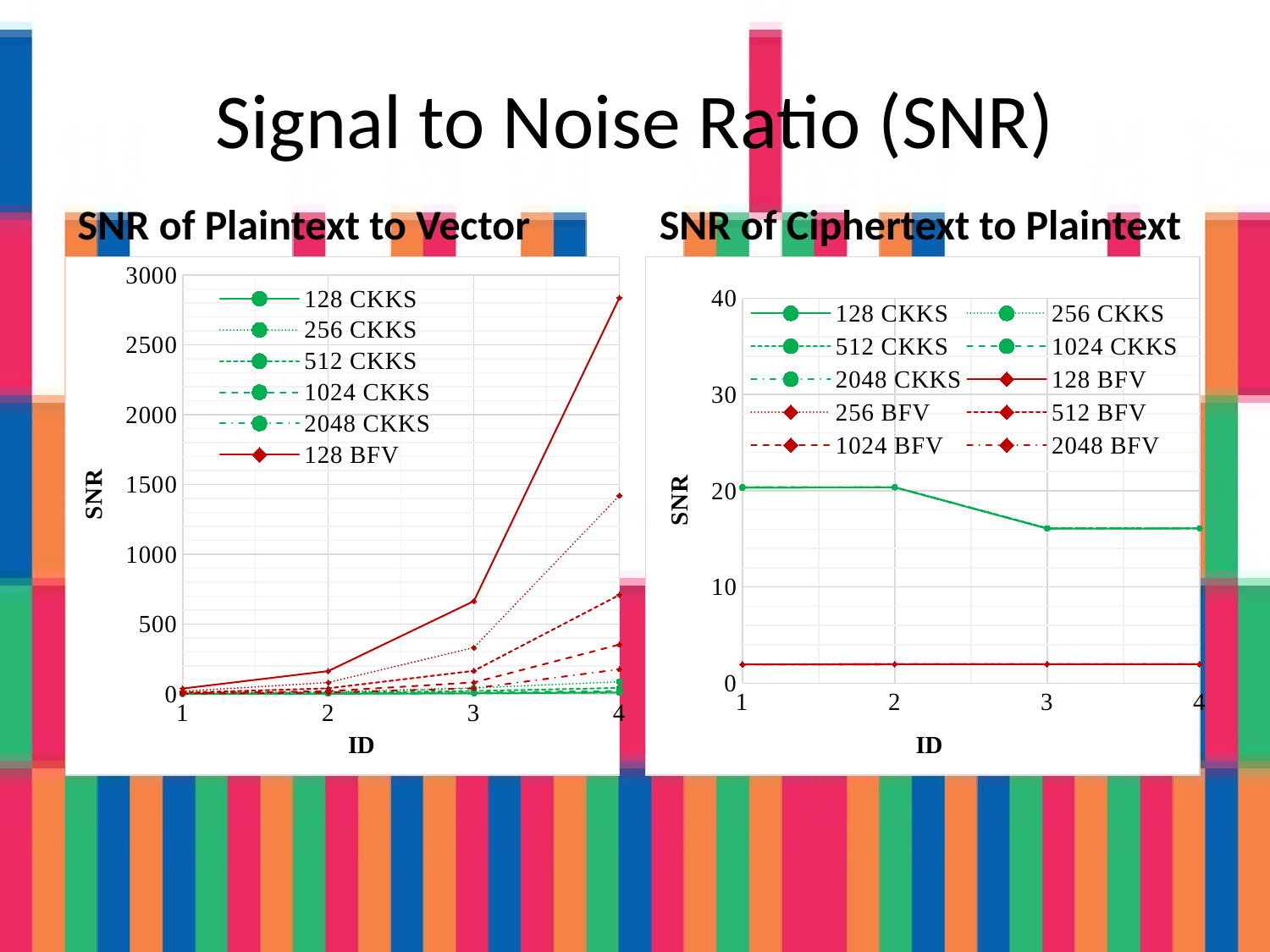
In the 'SNR of Ciphertext to Plaintext' chart, is the value for 128 BFV at ID 4 greater or less than 10? less In the 'SNR of Plaintext to Vector' chart, which is larger at ID 4: 128 BFV or 128 CKKS? 128 BFV In the 'SNR of Plaintext to Vector' chart, is the value for 128 BFV at ID 4 greater or less than 2500? greater In the 'SNR of Ciphertext to Plaintext' chart, how many series does the legend list? 10 In the 'SNR of Plaintext to Vector' chart, is the value for 128 BFV at ID 3 greater or less than 500? greater In the 'SNR of Plaintext to Vector' chart, how many ID values are shown on the x axis? 4 What kind of chart is the 'SNR of Ciphertext to Plaintext' chart? line chart In the 'SNR of Plaintext to Vector' chart, how many series are listed in the legend? 6 In the 'SNR of Plaintext to Vector' chart, which series has the highest value at ID 4? 128 BFV In the 'SNR of Plaintext to Vector' chart, does the 128 BFV line rise or fall from ID 1 to ID 4? rise What kind of chart is the 'SNR of Plaintext to Vector' chart? line chart What is the label on the y axis of the 'SNR of Ciphertext to Plaintext' chart? SNR